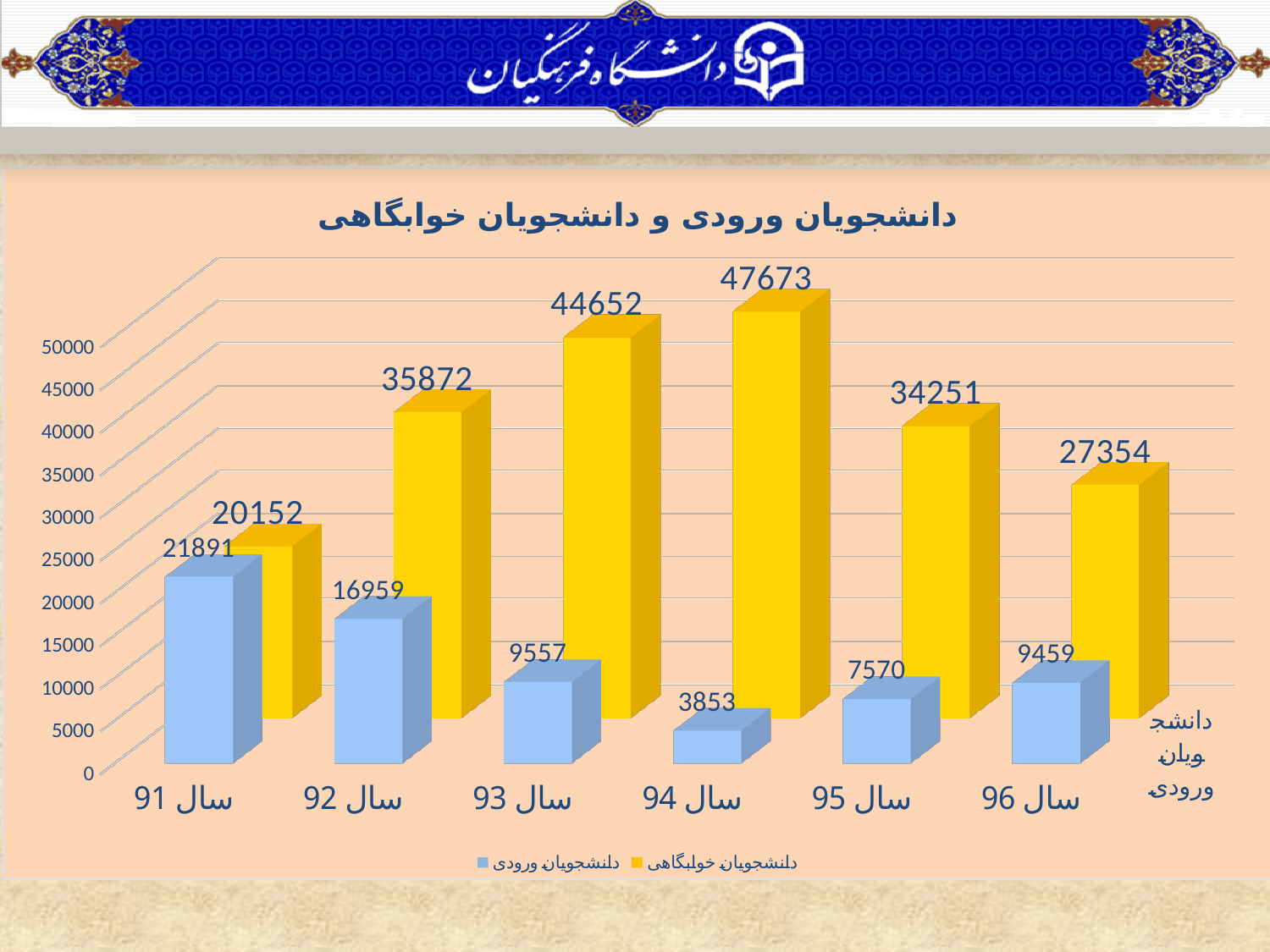
What is the value for دانشجویان ورودی in سال 92? 16959 Is the value for دانشجویان خوابگاهی in سال 95 greater or less than 30000? greater What kind of chart is shown on the slide? bar chart What is the difference between دانشجویان خوابگاهی and دانشجویان ورودی in سال 93? 35095 Which year has the lowest value for دانشجویان ورودی? سال 94 Does the value for دانشجویان ورودی rise or fall from سال 91 to سال 94? fall Which is larger in سال 91: دانشجویان ورودی or دانشجویان خوابگاهی? دانشجویان ورودی What is the value for دانشجویان خوابگاهی in سال 96? 27354 Which year has the highest value for دانشجویان خوابگاهی? سال 94 How many years are shown on the x axis? 6 How many series does the legend list? 2 What is the value for دانشجویان خوابگاهی in سال 94? 47673